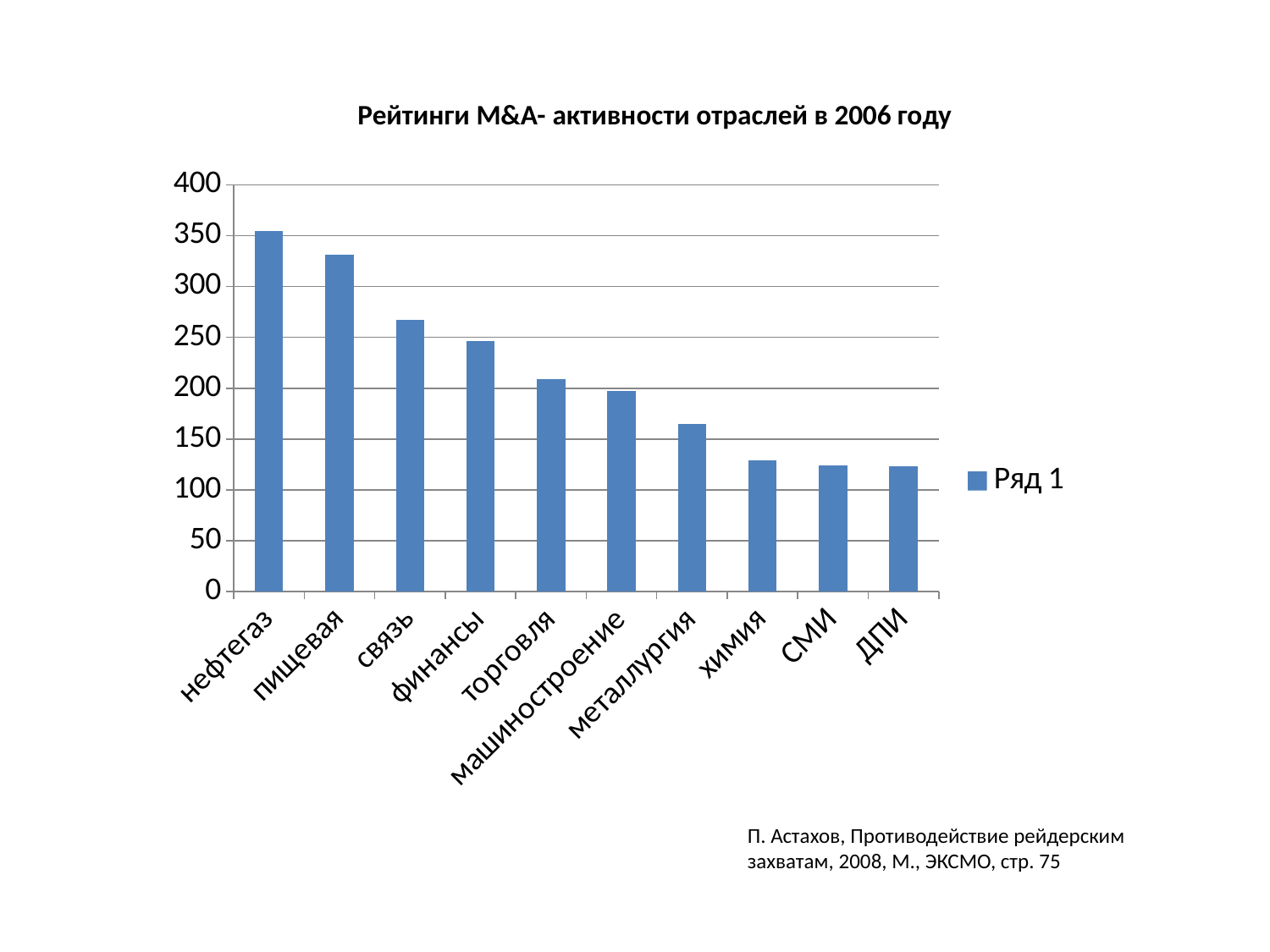
How many series does the legend list? 1 How many categories (industries) are shown on the x axis? 10 What kind of chart is shown on the slide? bar chart Which industry has the highest value? нефтегаз Is the value for пищевая greater or less than 300? greater Do the values rise or fall moving from left to right along the x axis? fall Is the value for химия greater or less than 150? less What is the title of the chart? Рейтинги M&A- активности отраслей в 2006 году Is the value for связь greater or less than 250? greater Which is larger, the value for связь or the value for торговля? связь